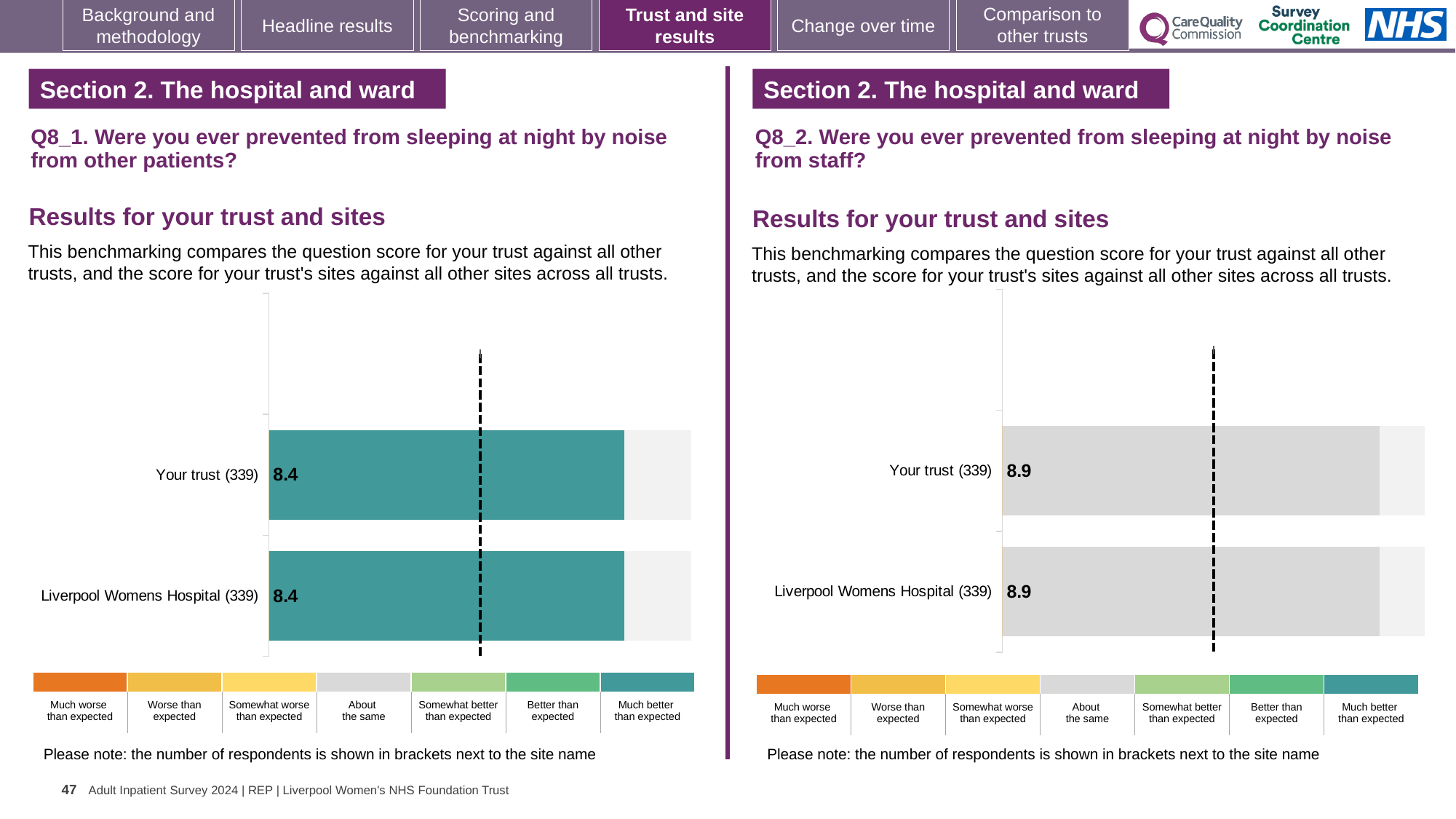
In the Q8_2 chart (right), what is the score for Liverpool Womens Hospital (339)? 8.9 What type of chart is used for the Q8_1 results (left)? Bar chart Which benchmark category does the colour of the bars in the Q8_1 chart (left) correspond to in the legend? Much better than expected In the Q8_1 chart (left), what is the score for Your trust (339)? 8.4 How many bars are plotted in the Q8_1 chart (left)? 2 In the Q8_2 chart (right), what is the score for Your trust (339)? 8.9 How many bars are plotted in the Q8_2 chart (right)? 2 How many respondents are shown in brackets for Liverpool Womens Hospital in the Q8_2 chart (right)? 339 In the Q8_1 chart (left), what is the difference between the score for Your trust and the score for Liverpool Womens Hospital? 0 Which benchmark category does the colour of the bars in the Q8_2 chart (right) correspond to in the legend? About the same In the Q8_2 chart (right), what is the difference between the score for Your trust and the score for Liverpool Womens Hospital? 0 In the Q8_1 chart (left), what is the score for Liverpool Womens Hospital (339)? 8.4